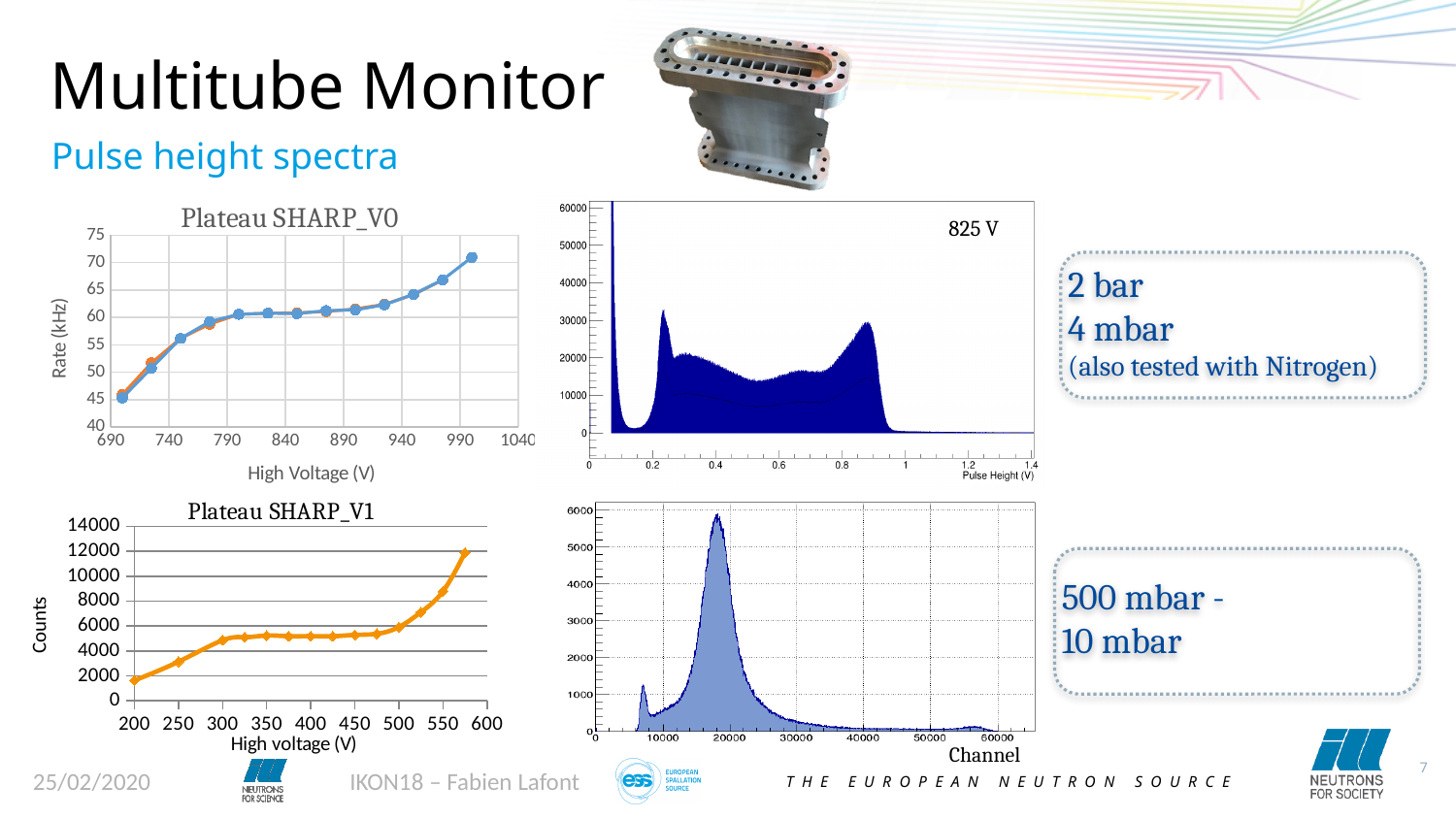
In the 'Plateau SHARP_V1' chart, do the counts rise or fall as high voltage increases from 200 V to 600 V? rise In the 'Plateau SHARP_V0' chart, what is the label of the y axis? Rate (kHz) In the 'Plateau SHARP_V0' chart, does the rate rise or fall as high voltage increases from 690 V to 1040 V? rises In the 'Plateau SHARP_V1' chart, are the counts at 575 V greater or less than 10000? greater In the 'Plateau SHARP_V1' chart, what is the label of the x axis? High voltage (V) In the 'Plateau SHARP_V0' chart, is the rate at 700 V greater or less than 50 kHz? less In the bottom-right spectrum chart (x axis 'Channel'), is the height of the main peak greater or less than 5000? greater What type of chart is the 'Plateau SHARP_V0' chart? line chart